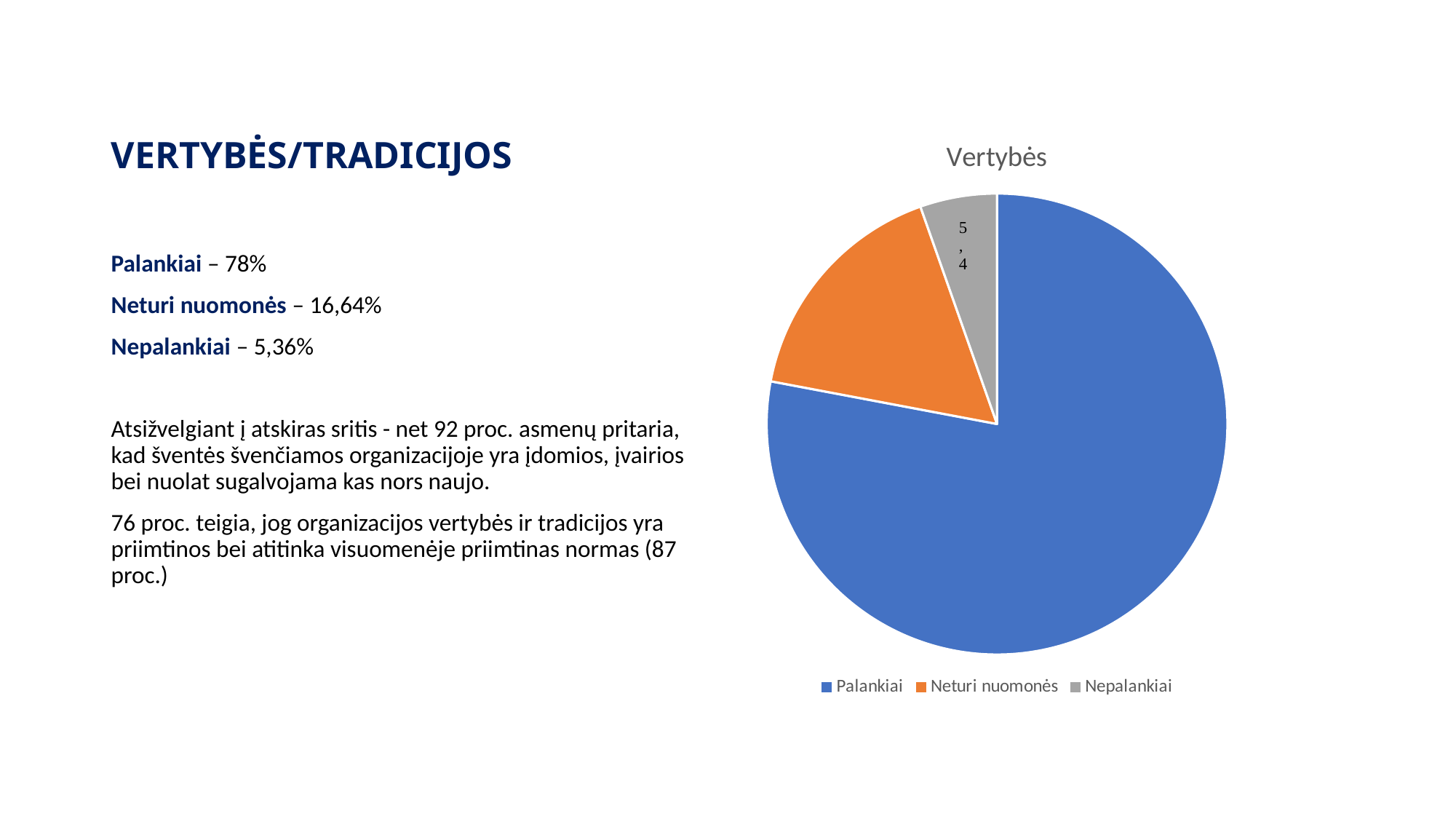
Which category has the largest slice of the pie? Palankiai Which slice is larger, Neturi nuomonės or Nepalankiai? Neturi nuomonės Does the Palankiai slice take up more or less than half of the pie? more Which category has the smallest slice of the pie? Nepalankiai How many entries does the chart legend list? 3 How many slices does the pie chart have? 3 What is the title of the chart? Vertybės What kind of chart is shown on the slide? pie chart What colour is the Neturi nuomonės slice? orange What data label is printed on the Nepalankiai slice? 5,4 Which slice is larger, Palankiai or Neturi nuomonės? Palankiai